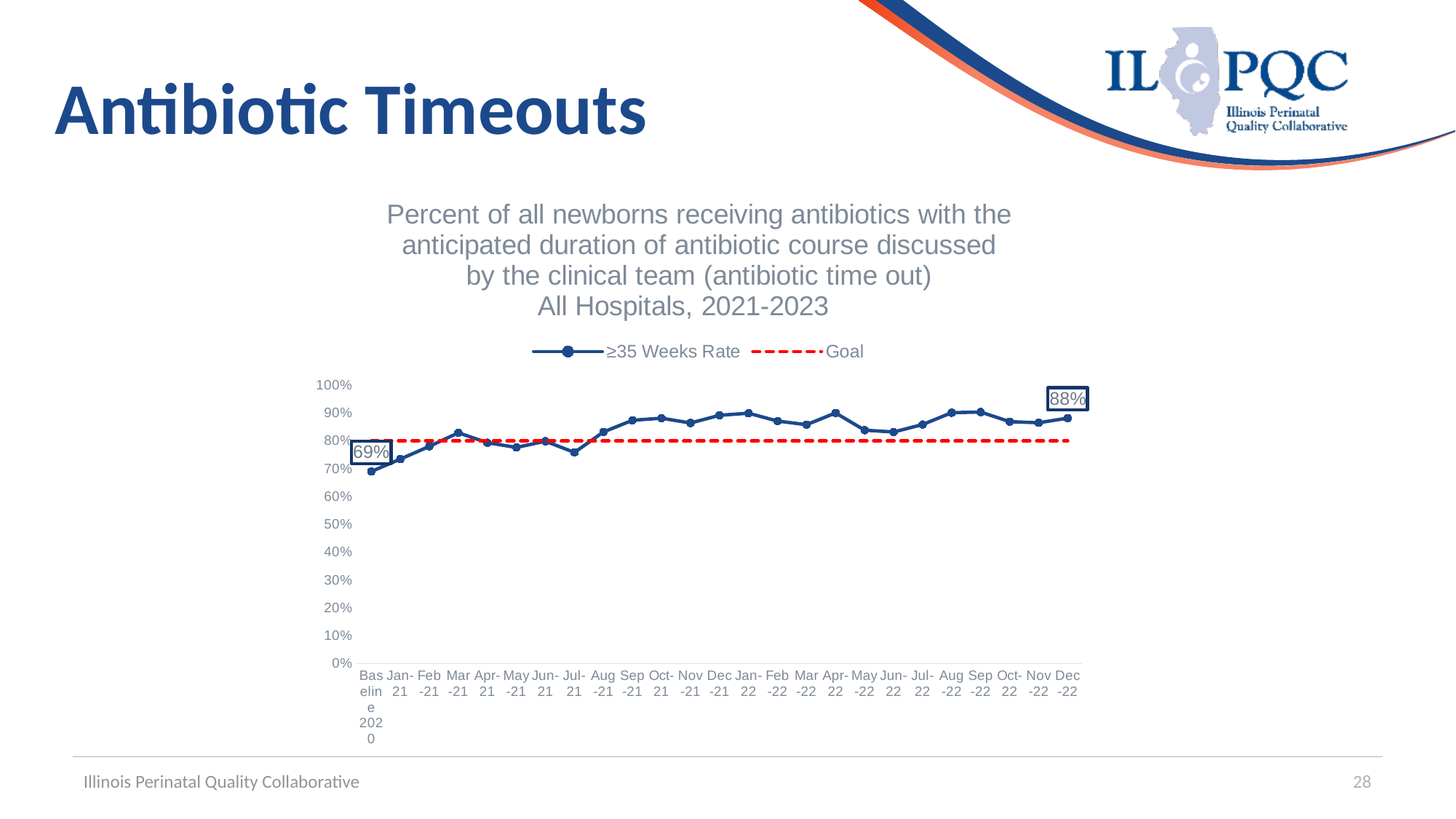
Is the ≥35 Weeks Rate for Jan-22 greater or less than 80%? greater Which time point has the lowest ≥35 Weeks Rate? Baseline 2020 What kind of chart is shown on the slide? Line chart What are the two entries in the chart legend? ≥35 Weeks Rate and Goal How many series does the legend list? 2 By how many percentage points did the ≥35 Weeks Rate increase from Baseline 2020 to Dec-22? 19 percentage points What is the ≥35 Weeks Rate at Baseline 2020? 69% Which is larger, the ≥35 Weeks Rate for Jul-21 or for Jan-22? Jan-22 Is the ≥35 Weeks Rate for Jul-21 greater or less than 80%? less How many time points are plotted on the x axis? 25 What is the ≥35 Weeks Rate for Dec-22? 88% Does the ≥35 Weeks Rate generally rise or fall from Baseline 2020 to Dec-22? Rise